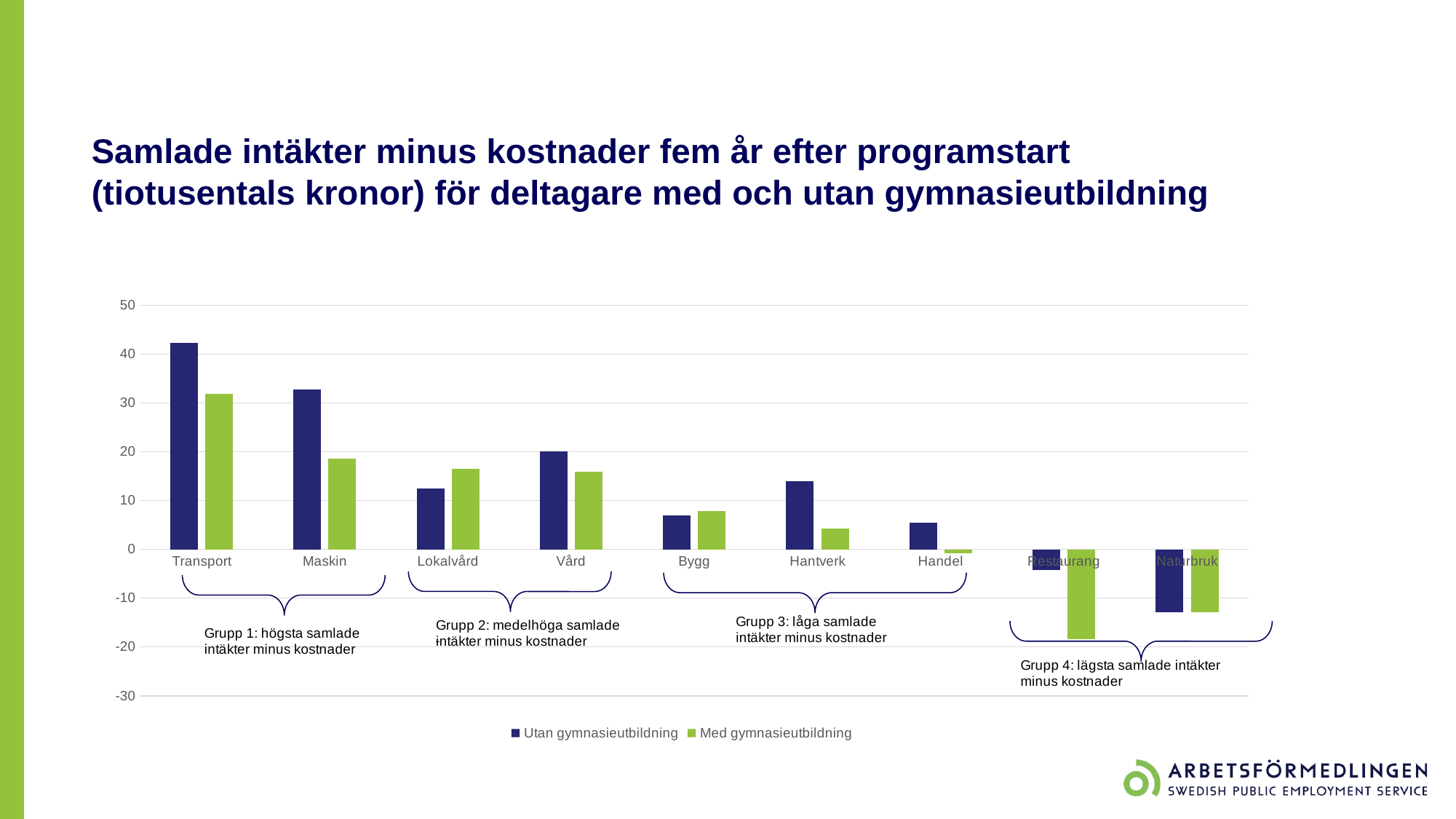
Is the value for Restaurang in the Med gymnasieutbildning series greater or less than -10? less Is the value for Transport in the Utan gymnasieutbildning series greater or less than 30? greater How many series does the legend list? 2 Which category has the lowest value for Med gymnasieutbildning? Restaurang Which category has the highest value for Utan gymnasieutbildning? Transport For Hantverk, which series has the larger value, Utan gymnasieutbildning or Med gymnasieutbildning? Utan gymnasieutbildning Is the value for Maskin in the Utan gymnasieutbildning series greater or less than 30? greater What kind of chart is shown on the slide? Bar chart Do the values for Utan gymnasieutbildning generally rise or fall from left to right along the x axis? fall How many categories are shown on the x axis? 9 For Lokalvård, which series has the larger value, Utan gymnasieutbildning or Med gymnasieutbildning? Med gymnasieutbildning Which category has the highest value for Med gymnasieutbildning? Transport